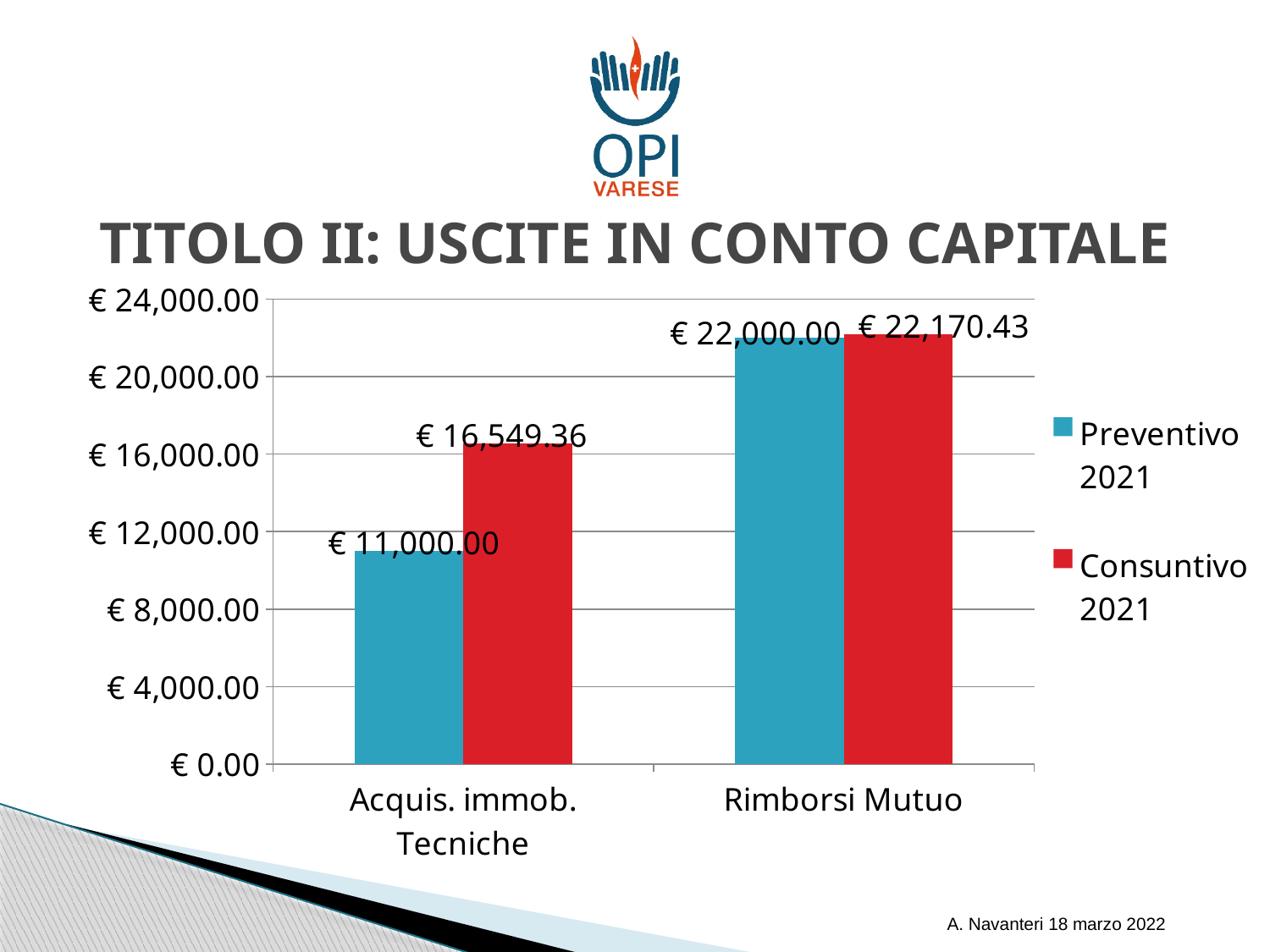
What is the difference between the Consuntivo 2021 and Preventivo 2021 values for Acquis. immob. Tecniche? € 5,549.36 How many categories are shown on the x axis? 2 Which category has the highest Consuntivo 2021 value? Rimborsi Mutuo Which category has the lowest Preventivo 2021 value? Acquis. immob. Tecniche For Acquis. immob. Tecniche, which is larger: the Preventivo 2021 value or the Consuntivo 2021 value? Consuntivo 2021 What is the Preventivo 2021 value for Acquis. immob. Tecniche? € 11,000.00 What is the Consuntivo 2021 value for Rimborsi Mutuo? € 22,170.43 What is the Consuntivo 2021 value for Acquis. immob. Tecniche? € 16,549.36 What type of chart is shown on the slide? Bar chart What is the Preventivo 2021 value for Rimborsi Mutuo? € 22,000.00 How many series does the legend list? 2 What is the difference between the Consuntivo 2021 and Preventivo 2021 values for Rimborsi Mutuo? € 170.43